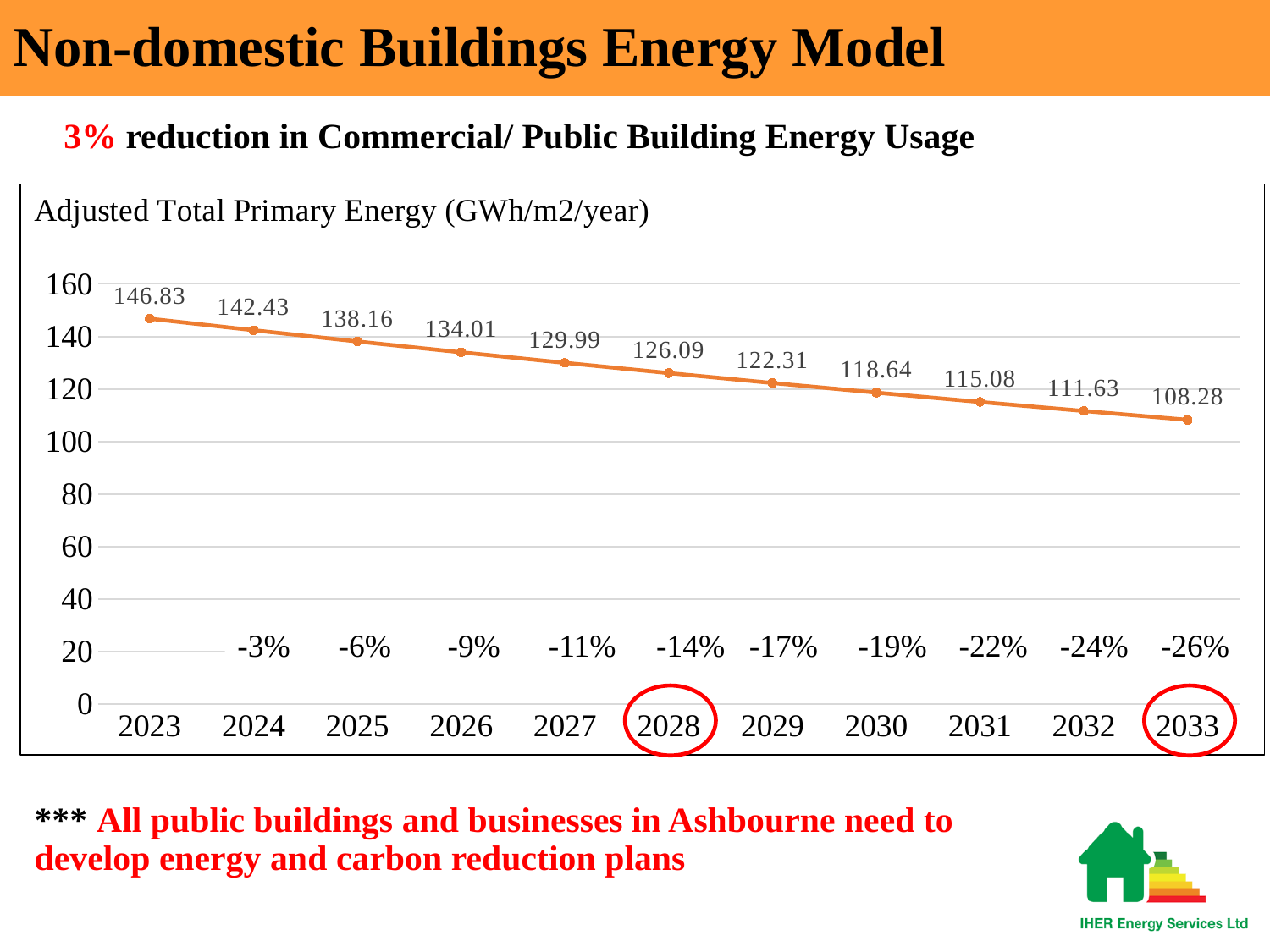
What kind of chart is shown on the slide? line chart Do the values rise or fall from 2023 to 2033? fall What is the Adjusted Total Primary Energy value for 2033? 108.28 What is the Adjusted Total Primary Energy value for 2023? 146.83 How many years are plotted on the chart? 11 Which is larger, the value for 2025 or the value for 2029? 2025 Which year has the lowest Adjusted Total Primary Energy value? 2033 Which year has the highest Adjusted Total Primary Energy value? 2023 What percentage reduction is shown for 2030? -19% What is the difference between the 2023 value and the 2033 value? 38.55 Is the value for 2031 greater or less than 120? less What is the Adjusted Total Primary Energy value for 2028? 126.09